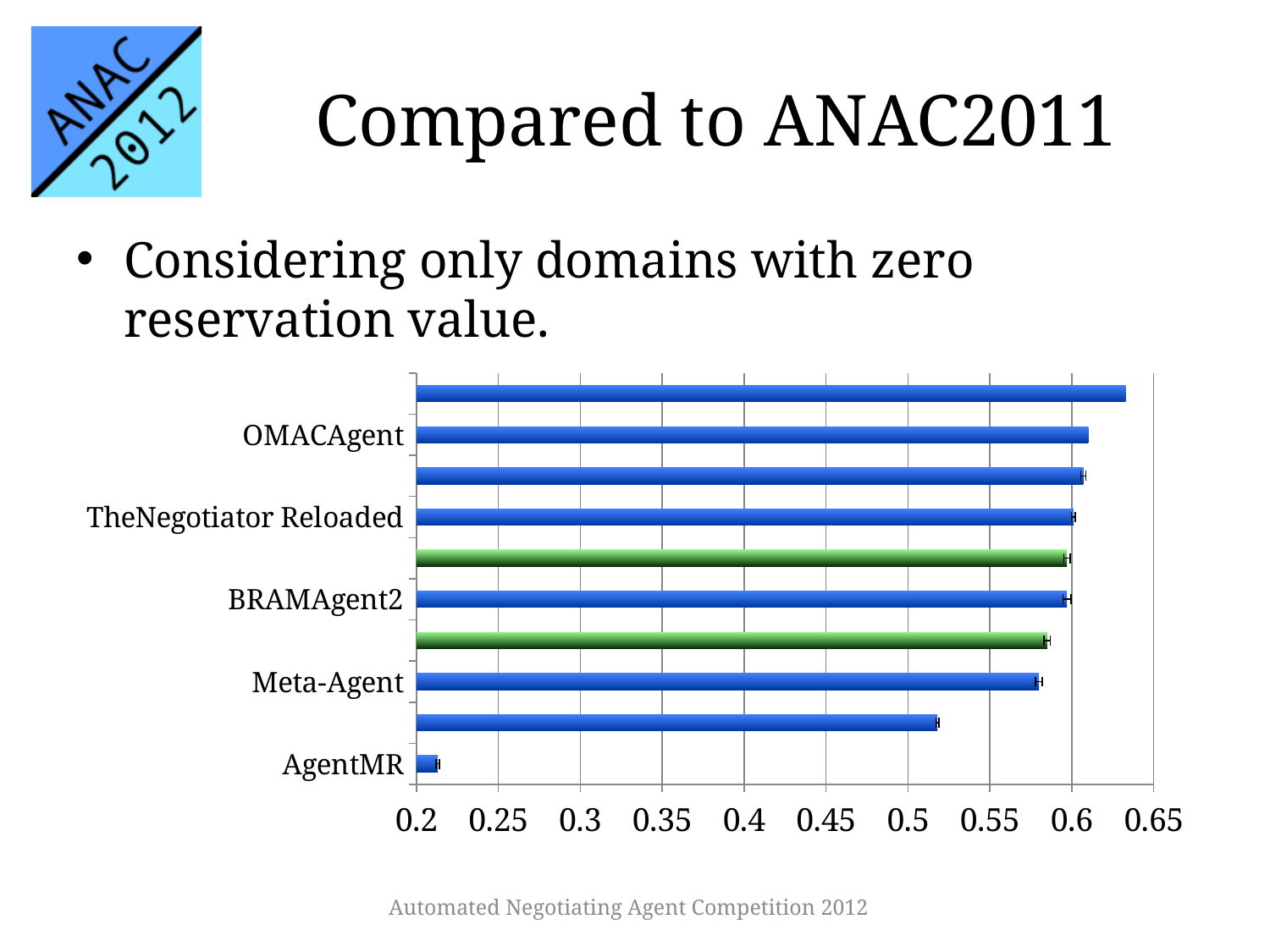
Is the value for AgentMR greater or less than 0.25? less Is the value for Meta-Agent greater or less than 0.6? less Which has the larger value, OMACAgent or AgentMR? OMACAgent What is the highest value shown on the x axis? 0.65 Is the value for OMACAgent greater or less than 0.55? greater Which has the larger value, Meta-Agent or OMACAgent? OMACAgent How many bars are plotted in the chart? 10 Which category has the lowest value in the chart? AgentMR What kind of chart is shown on the slide? bar chart How many bars in the chart are coloured green? 2